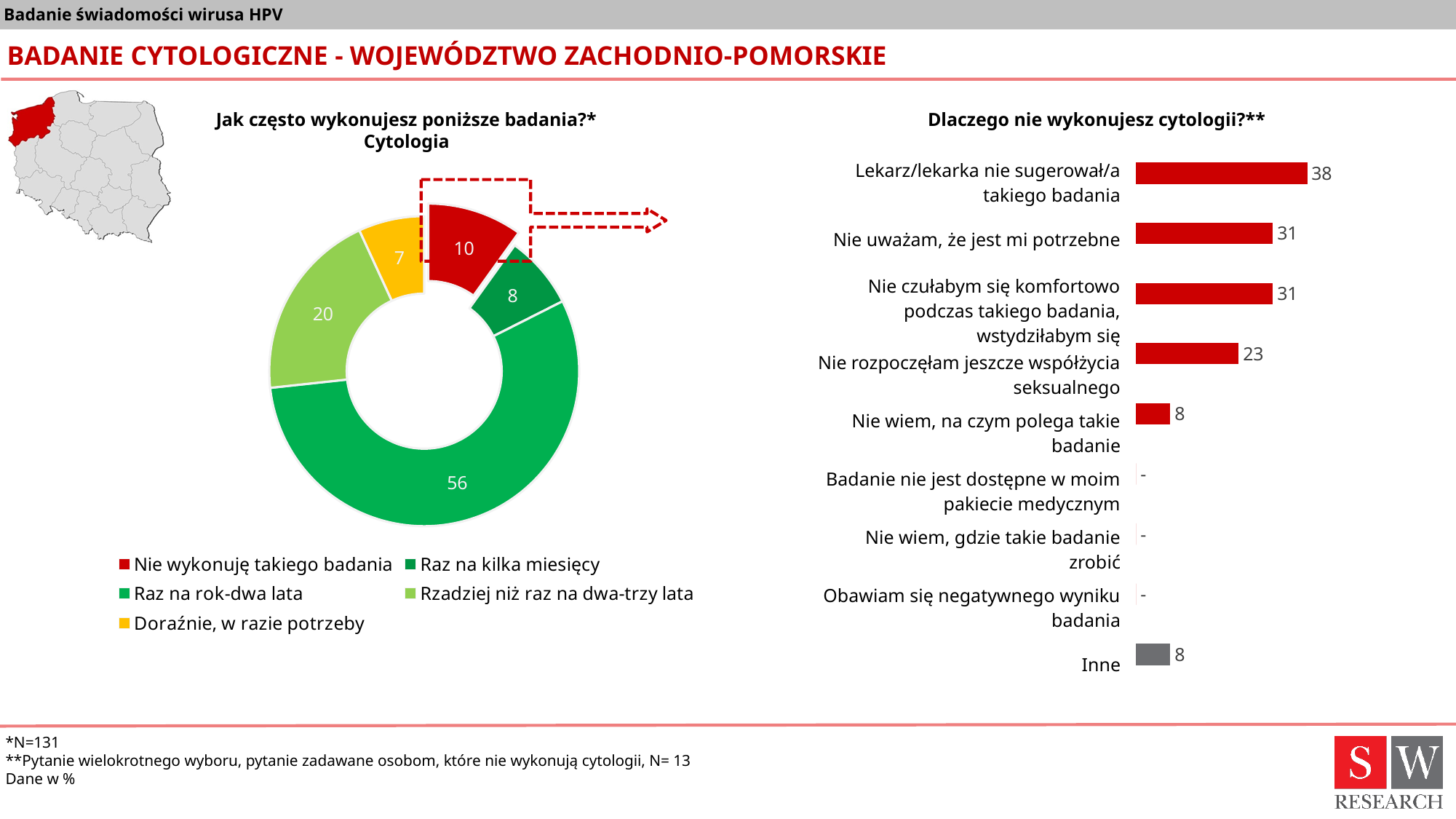
In the chart 'Jak często wykonujesz poniższe badania? Cytologia', what is the difference between 'Raz na rok-dwa lata' and 'Rzadziej niż raz na dwa-trzy lata'? 36 In the chart 'Jak często wykonujesz poniższe badania? Cytologia', what is the value for 'Nie wykonuję takiego badania'? 10 In the chart 'Dlaczego nie wykonujesz cytologii?', what is the value for 'Nie rozpoczęłam jeszcze współżycia seksualnego'? 23 What kind of chart is 'Dlaczego nie wykonujesz cytologii?'? Bar chart What kind of chart is 'Jak często wykonujesz poniższe badania? Cytologia'? Pie (donut) chart In the chart 'Jak często wykonujesz poniższe badania? Cytologia', which category has the smallest share? Doraźnie, w razie potrzeby How many categories does the legend of the chart 'Jak często wykonujesz poniższe badania? Cytologia' list? 5 In the chart 'Dlaczego nie wykonujesz cytologii?', what is the value for 'Lekarz/lekarka nie sugerował/a takiego badania'? 38 In the chart 'Jak często wykonujesz poniższe badania? Cytologia', which category has the largest share? Raz na rok-dwa lata In the chart 'Dlaczego nie wykonujesz cytologii?', which is larger: 'Nie uważam, że jest mi potrzebne' or 'Nie wiem, na czym polega takie badanie'? Nie uważam, że jest mi potrzebne In the chart 'Jak często wykonujesz poniższe badania? Cytologia', what is the value for 'Raz na rok-dwa lata'? 56 In the chart 'Dlaczego nie wykonujesz cytologii?', which reason has the highest value? Lekarz/lekarka nie sugerował/a takiego badania